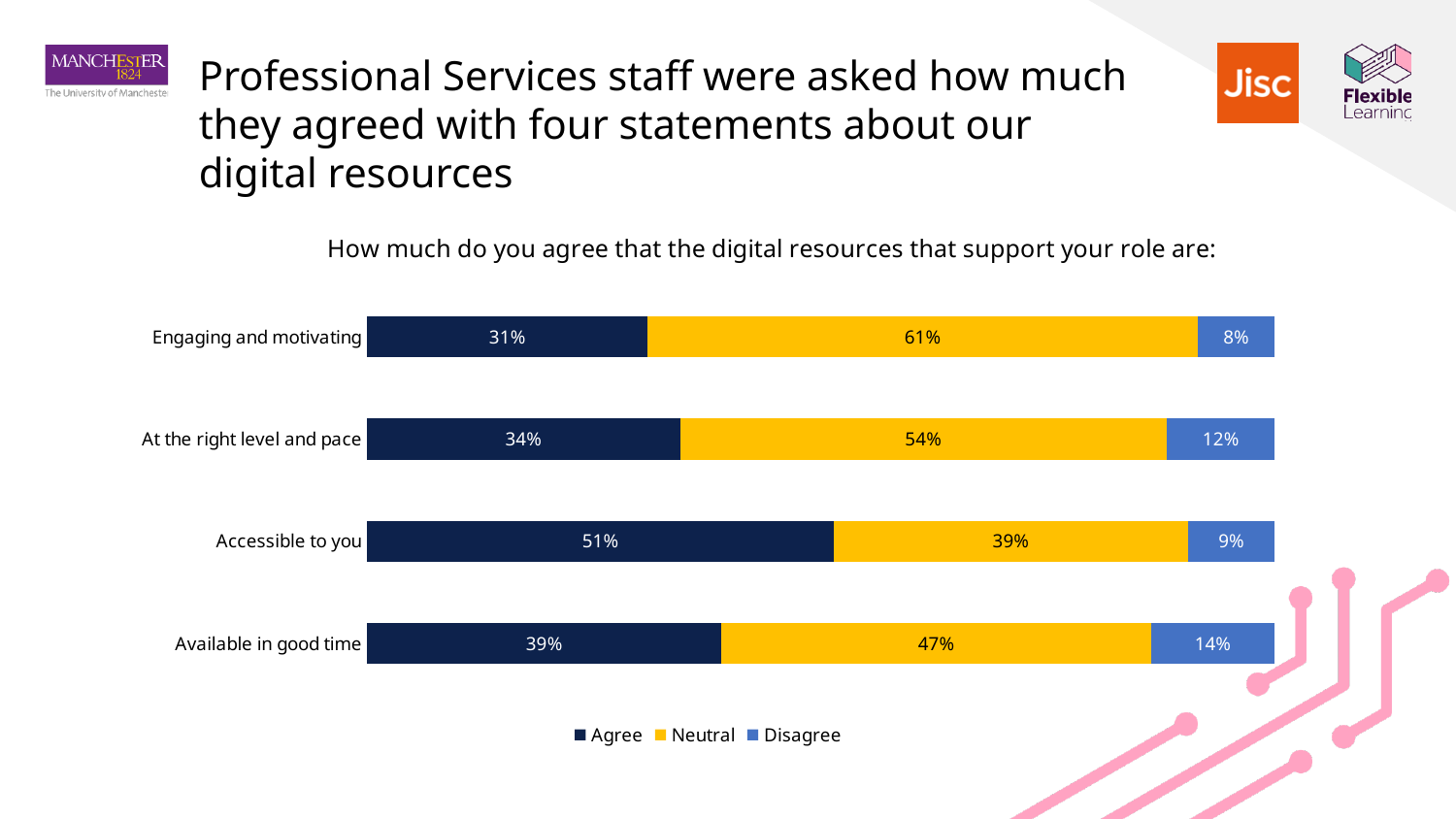
Which statement has the lowest Disagree percentage? Engaging and motivating How many series does the legend list? 3 What percentage of Professional Services staff agreed that digital resources are accessible to them? 51% Which statement has the highest Agree percentage? Accessible to you What is the difference between the Neutral and Agree values for 'Engaging and motivating'? 30% How many statements are shown in the chart? 4 What kind of chart is shown on the slide? Stacked bar chart What is the Disagree value for 'Available in good time'? 14% What is the Agree value for 'At the right level and pace'? 34% Which colour represents the Neutral series in the chart? Yellow What is the Neutral value for 'Engaging and motivating'? 61% Is the Agree value larger for 'Available in good time' or 'At the right level and pace'? Available in good time